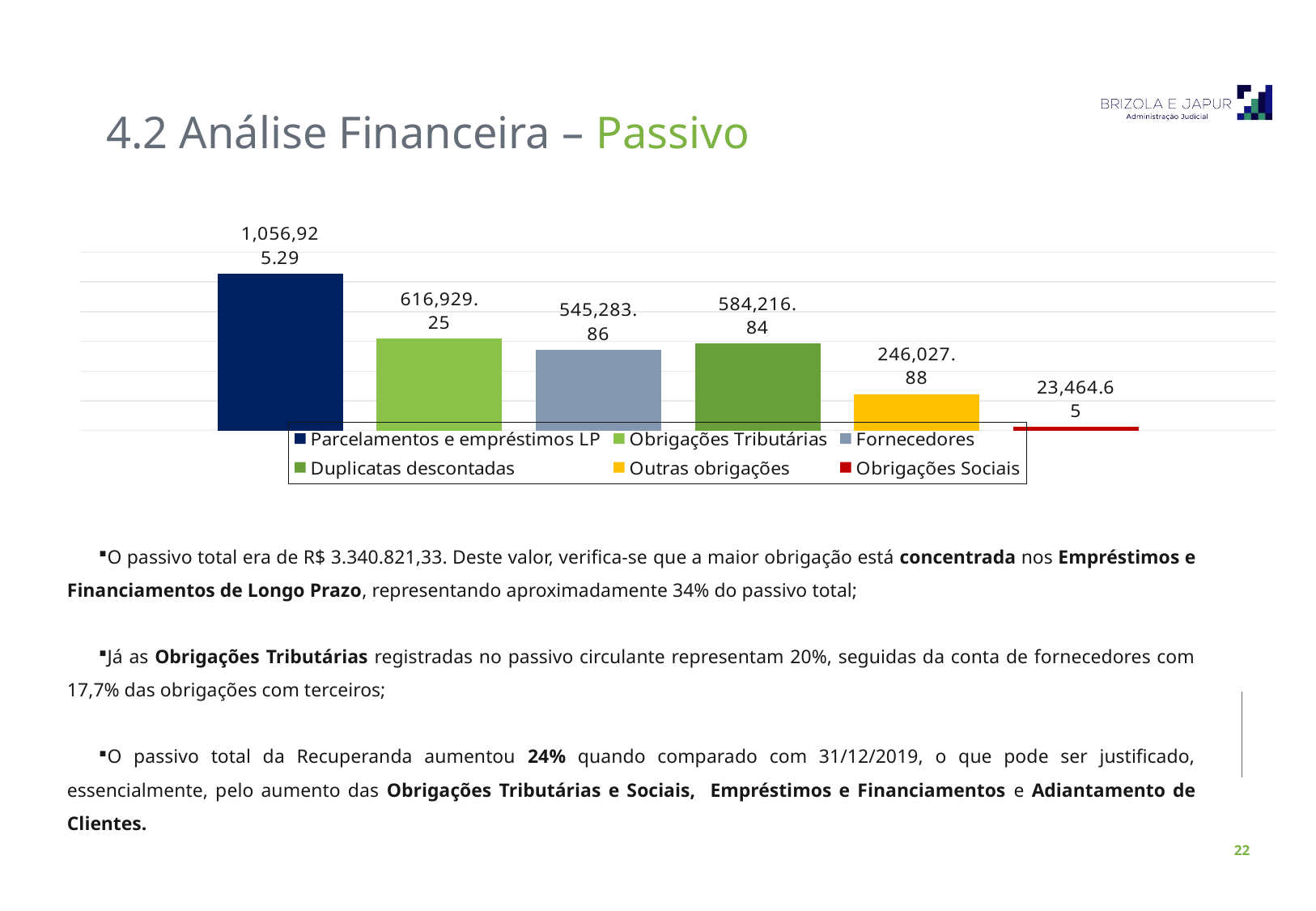
What is the value shown for Obrigações Tributárias? 616,929.25 What is the value shown for Obrigações Sociais? 23,464.65 What is the value shown for Outras obrigações? 246,027.88 What is the value shown for Parcelamentos e empréstimos LP? 1,056,925.29 Which is larger, the value for Duplicatas descontadas or the value for Fornecedores? Duplicatas descontadas Which series has the lowest value in the chart? Obrigações Sociais Which legend entry is shown in red? Obrigações Sociais Which series has the highest value in the chart? Parcelamentos e empréstimos LP What is the difference between the values for Obrigações Tributárias and Duplicatas descontadas? 32,712.41 What is the value shown for Fornecedores? 545,283.86 How many series does the legend list? 6 What kind of chart is shown on the slide? Bar chart